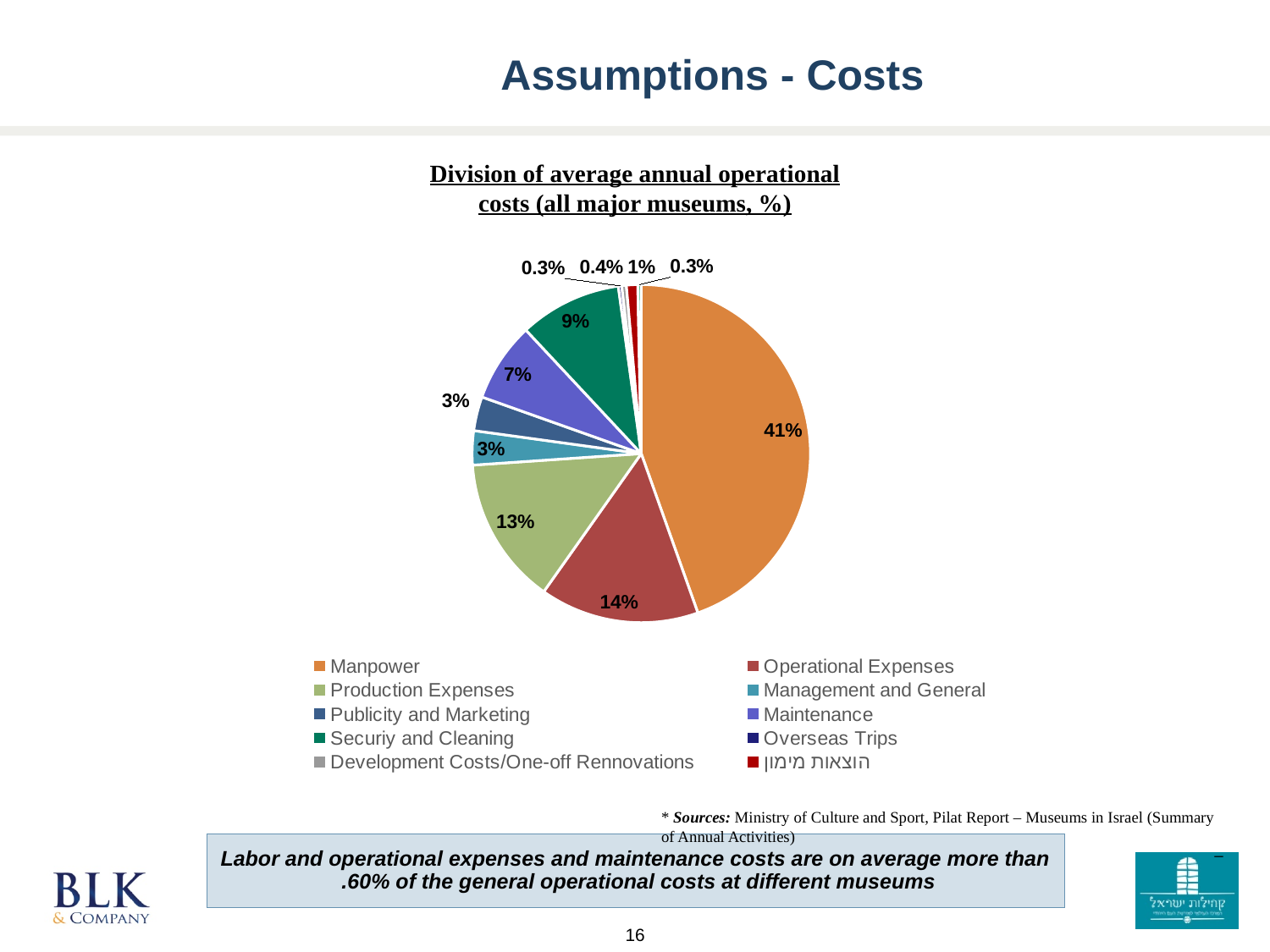
What percentage of costs is Maintenance? 7% What percentage of costs is Operational Expenses? 14% How many entries does the legend list? 10 What type of chart is shown on the slide? Pie chart Which is larger, the share for Securiy and Cleaning or the share for Maintenance? Securiy and Cleaning What colour is the Manpower slice? Orange What percentage of costs is Production Expenses? 13% What is the title of the chart? Division of average annual operational costs (all major museums, %) What share of average annual operational costs is Manpower? 41% What percentage of costs is Securiy and Cleaning? 9% Which category has the largest share of the pie? Manpower What is the difference in percentage points between Manpower and Operational Expenses? 27